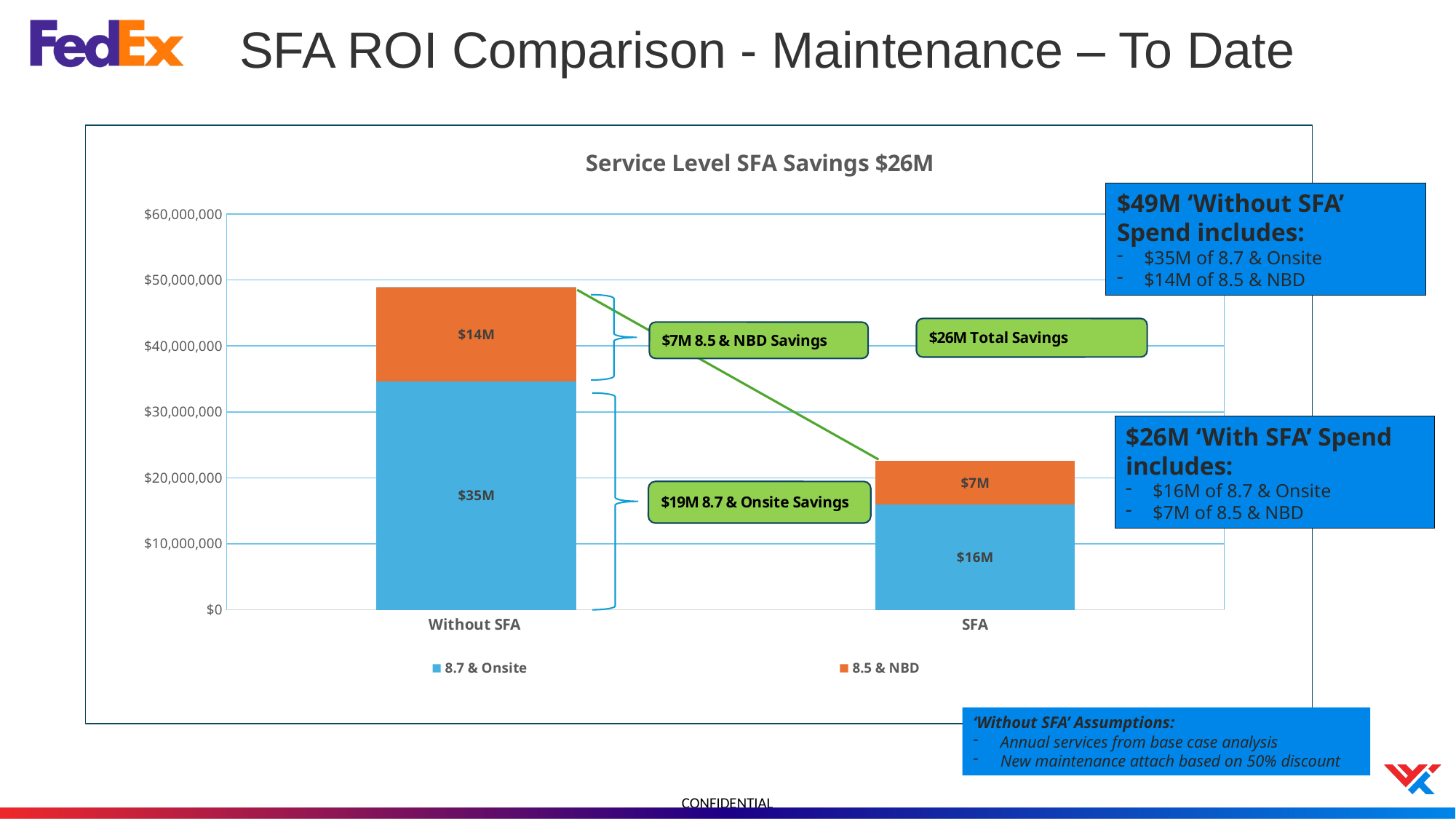
What is the total of the stacked bar for Without SFA? $49M Is the total for the Without SFA bar greater or less than $40,000,000? greater What is the total of the stacked bar for SFA? $23M What is the value of the 8.5 & NBD segment for Without SFA? $14M Which category has the larger 8.5 & NBD value, Without SFA or SFA? Without SFA What is the value of the 8.7 & Onsite segment for SFA? $16M What is the difference between the 8.7 & Onsite values for Without SFA and SFA? $19M What kind of chart is shown? Stacked bar chart What is the value of the 8.7 & Onsite segment for Without SFA? $35M What is the value of the 8.5 & NBD segment for SFA? $7M What is the title of the chart? Service Level SFA Savings $26M How many series does the legend list? 2